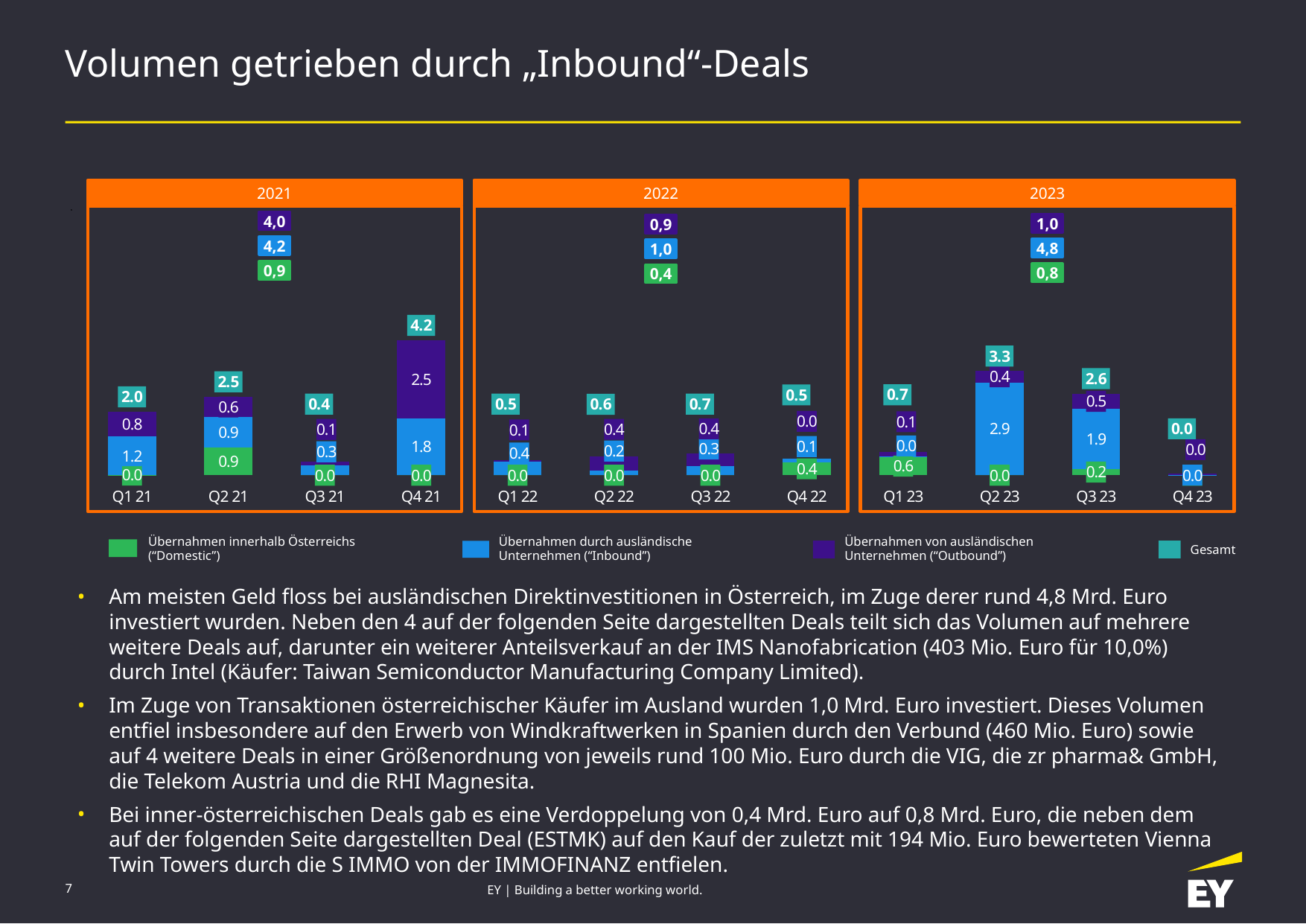
In the 2022 chart, what is the Domestic value for Q4 22? 0.4 In the 2021 chart, what is the Gesamt (total) value for Q4 21? 4.2 In the 2022 chart, what is the annual Outbound total shown at the top of the panel? 0,9 In the 2021 chart, which quarter has the highest Gesamt value? Q4 21 How many series does the legend list? 4 In the 2023 chart, what is the annual Inbound total shown at the top of the panel? 4,8 In the 2023 chart, what is the Inbound value for Q2 23? 2.9 What kind of chart is used for the 2021, 2022 and 2023 panels? Stacked bar chart In the 2023 chart, which quarter has the lowest Gesamt value? Q4 23 How many quarters are shown in the 2022 chart? 4 In the 2021 chart, what is the difference between the Gesamt values for Q4 21 and Q2 21? 1.7 In the 2023 chart, which is larger: the Inbound value for Q2 23 or the Inbound value for Q3 23? Q2 23